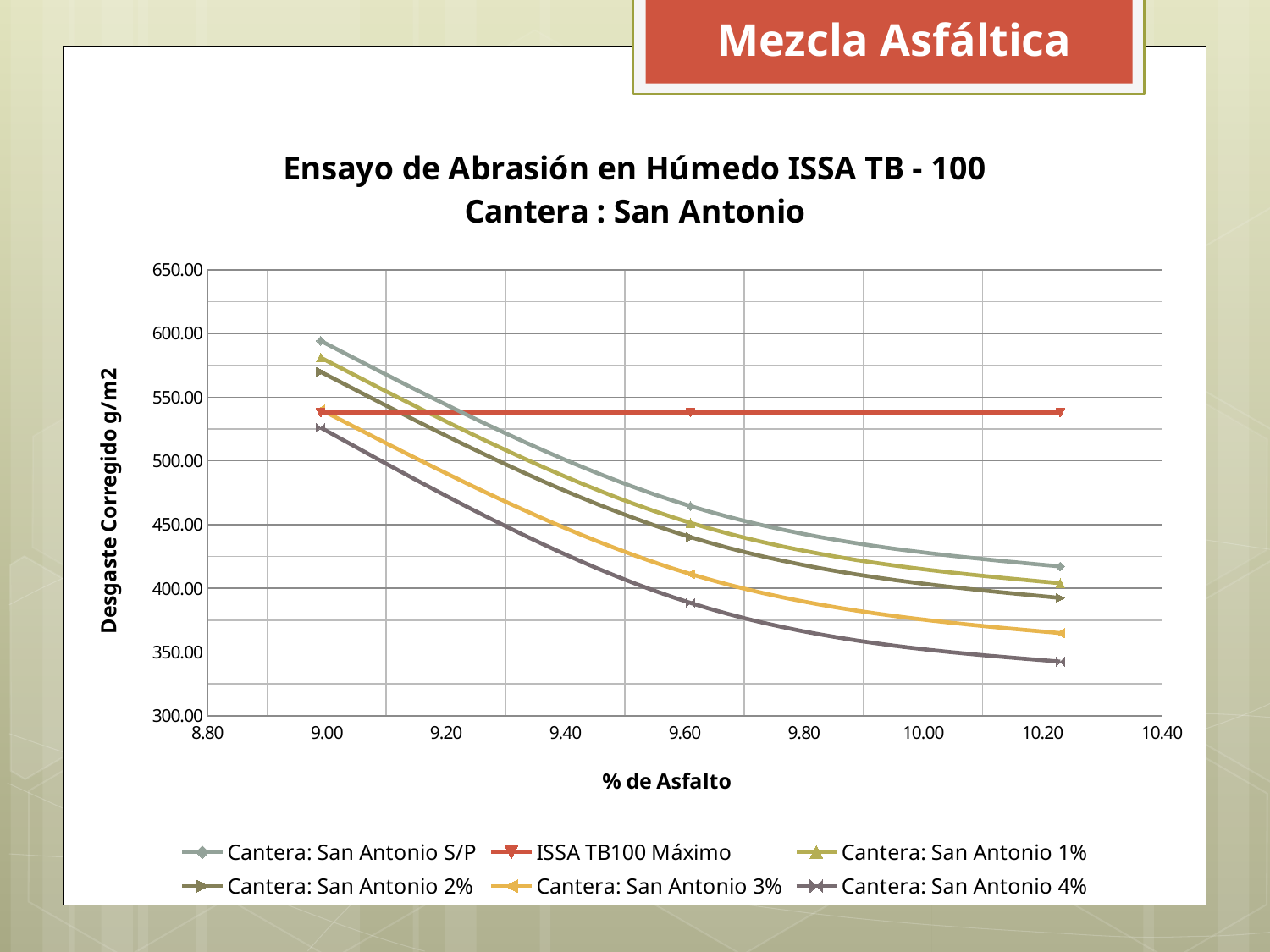
Is the ISSA TB100 Máximo line greater or less than 500.00? greater What kind of chart is shown on the slide? line chart What is the title of the chart? Ensayo de Abrasión en Húmedo ISSA TB - 100 Cantera : San Antonio Do the values for Cantera: San Antonio S/P rise or fall as % de Asfalto increases? fall Is the value for Cantera: San Antonio 4% at about 10.20 % de Asfalto greater or less than 350.00? less Is the value for Cantera: San Antonio S/P at 9.00 % de Asfalto greater or less than 550.00? greater Does the ISSA TB100 Máximo line rise, fall or stay constant across the x axis? stay constant How many series does the legend list? 6 What is the label of the y axis? Desgaste Corregido g/m2 Which series has the lowest value at about 10.20 % de Asfalto? Cantera: San Antonio 4% Which series has the highest value at 9.00 % de Asfalto? Cantera: San Antonio S/P